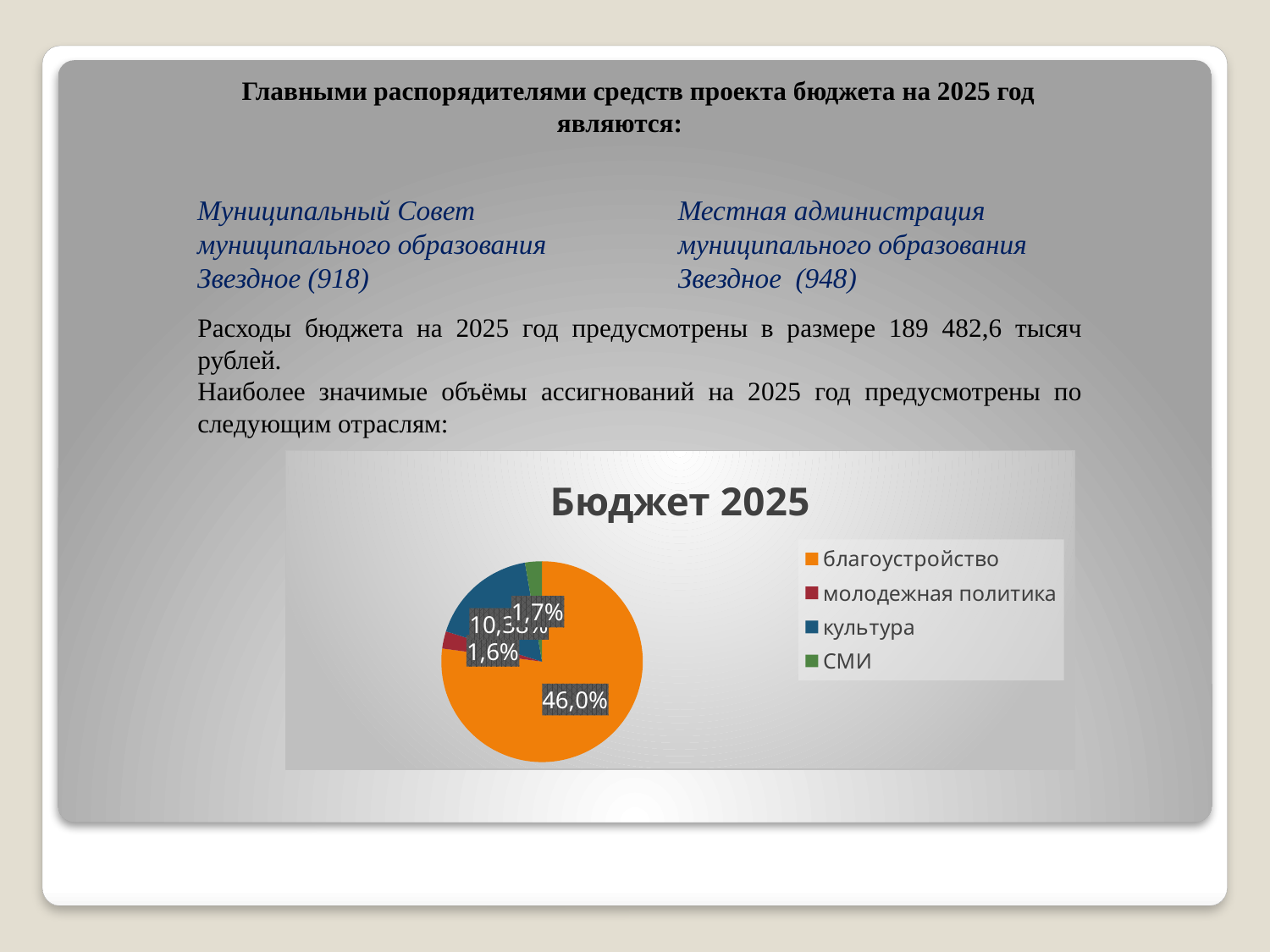
What is the difference between the shares for благоустройство and СМИ? 44,3% What share of the pie is labelled for благоустройство? 46,0% How many entries does the chart legend list? 4 What is the title of the chart? Бюджет 2025 What colour is the slice for благоустройство? orange Which slice is larger, культура or СМИ? культура Which category has the largest slice of the pie? благоустройство How many slices does the pie chart have? 4 What kind of chart is shown on the slide? pie chart What share of the pie is labelled for молодежная политика? 1,6% What share of the pie is labelled for СМИ? 1,7%